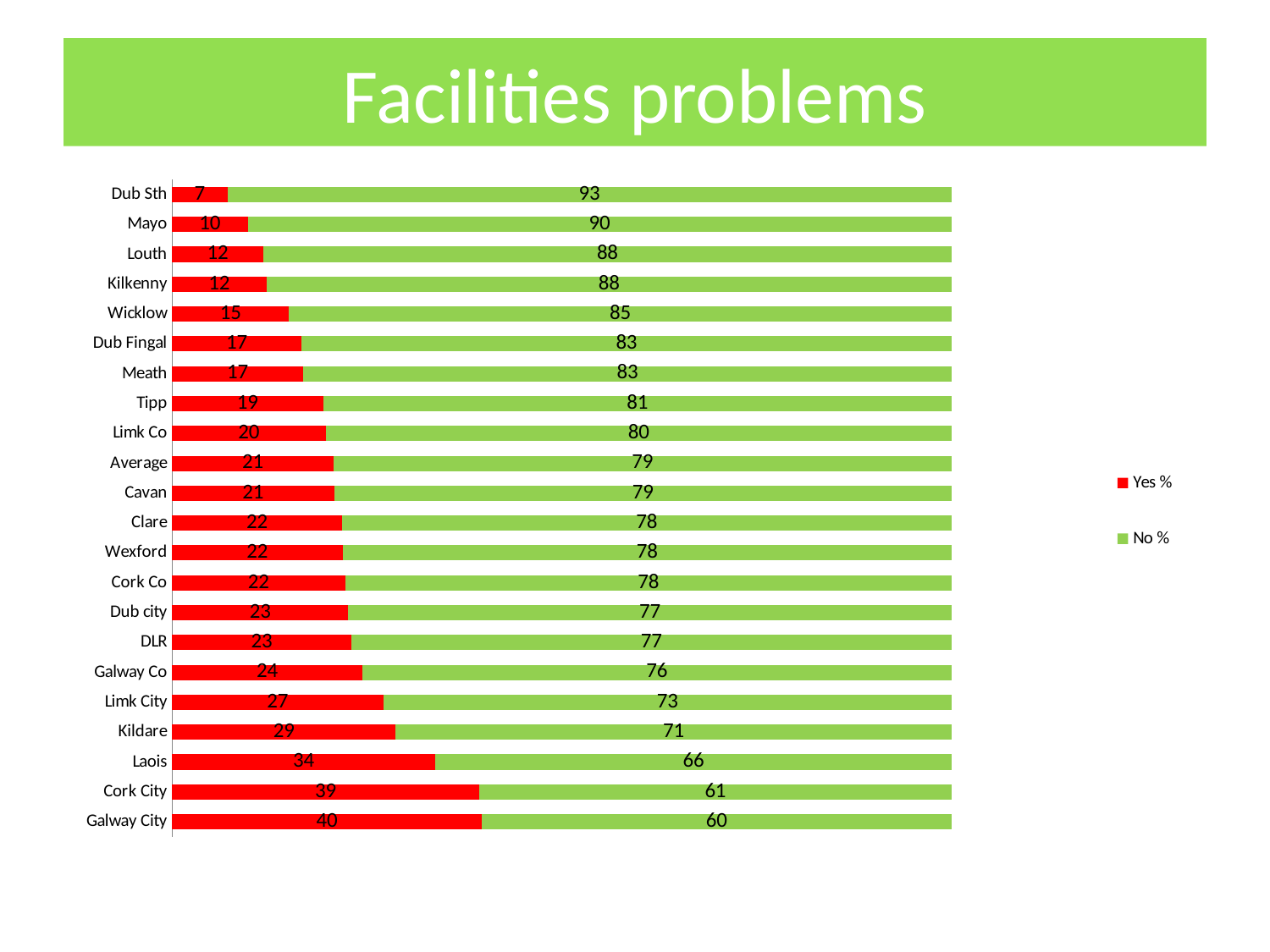
Which category has the highest Yes % value? Galway City How many categories are shown on the chart? 22 What is the total of the stacked bar for Wicklow? 100 What is the difference between the Yes % values for Cork City and Laois? 5 Which has a larger No % value, Kildare or Limk City? Limk City What is the Yes % value for Galway City? 40 What is the title of the slide? Facilities problems What is the No % value for Dub Sth? 93 How many series does the legend list? 2 What kind of chart is shown on the slide? Stacked bar chart Which category has the lowest Yes % value? Dub Sth What is the Yes % value for Average? 21